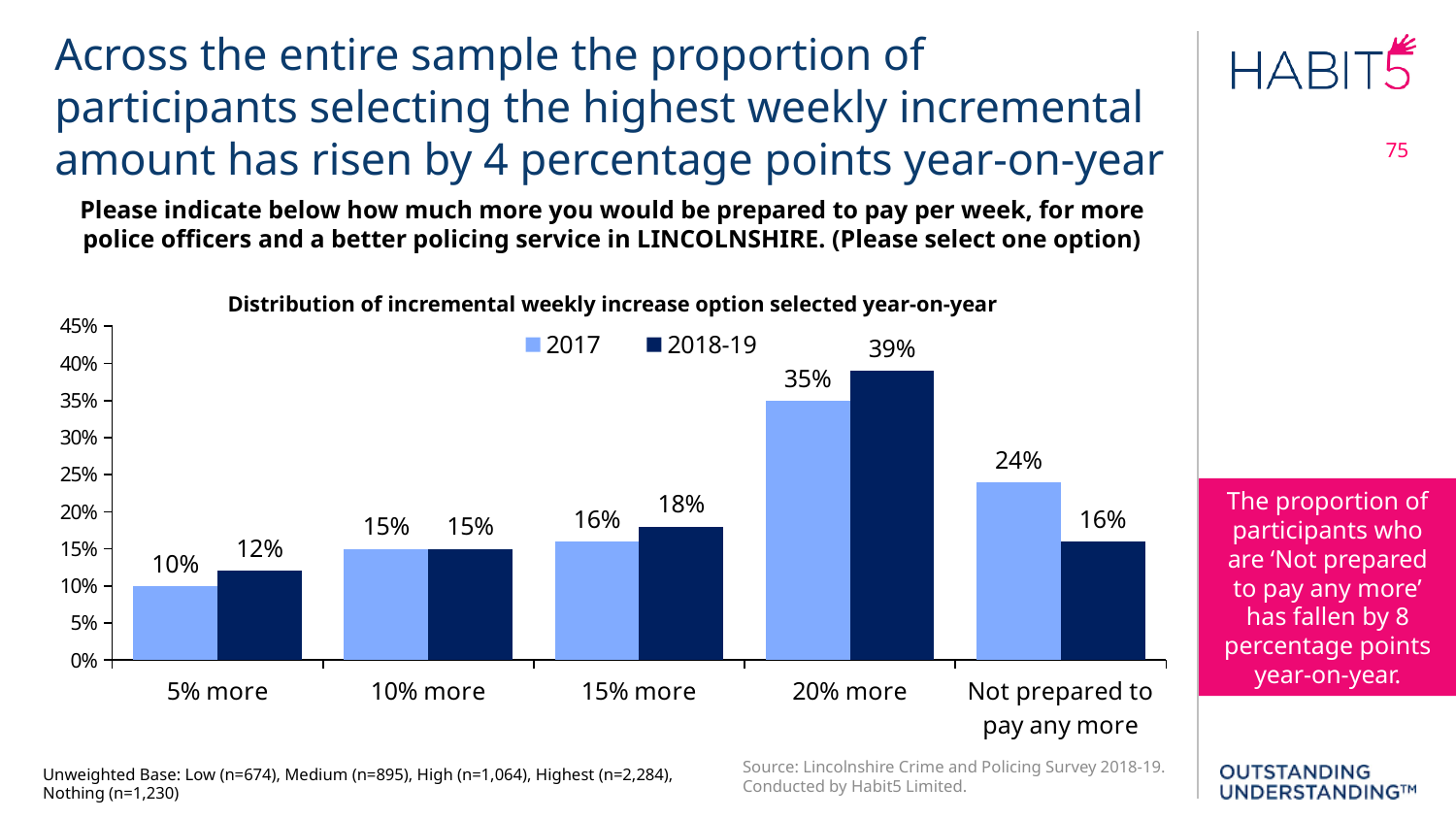
What is the 2018-19 value for '20% more'? 39% What kind of chart is shown on the slide? Bar chart What is the title of the chart? Distribution of incremental weekly increase option selected year-on-year How many categories are shown on the x axis? 5 What is the difference between the 2017 and 2018-19 values for 'Not prepared to pay any more'? 8% How many series does the legend list? 2 What is the 2018-19 value for '10% more'? 15% What is the 2017 value for 'Not prepared to pay any more'? 24% Which category has the lowest 2017 value? 5% more Which category has the highest 2018-19 value? 20% more Which is larger for '15% more': the 2017 value or the 2018-19 value? 2018-19 What is the 2017 value for '5% more'? 10%